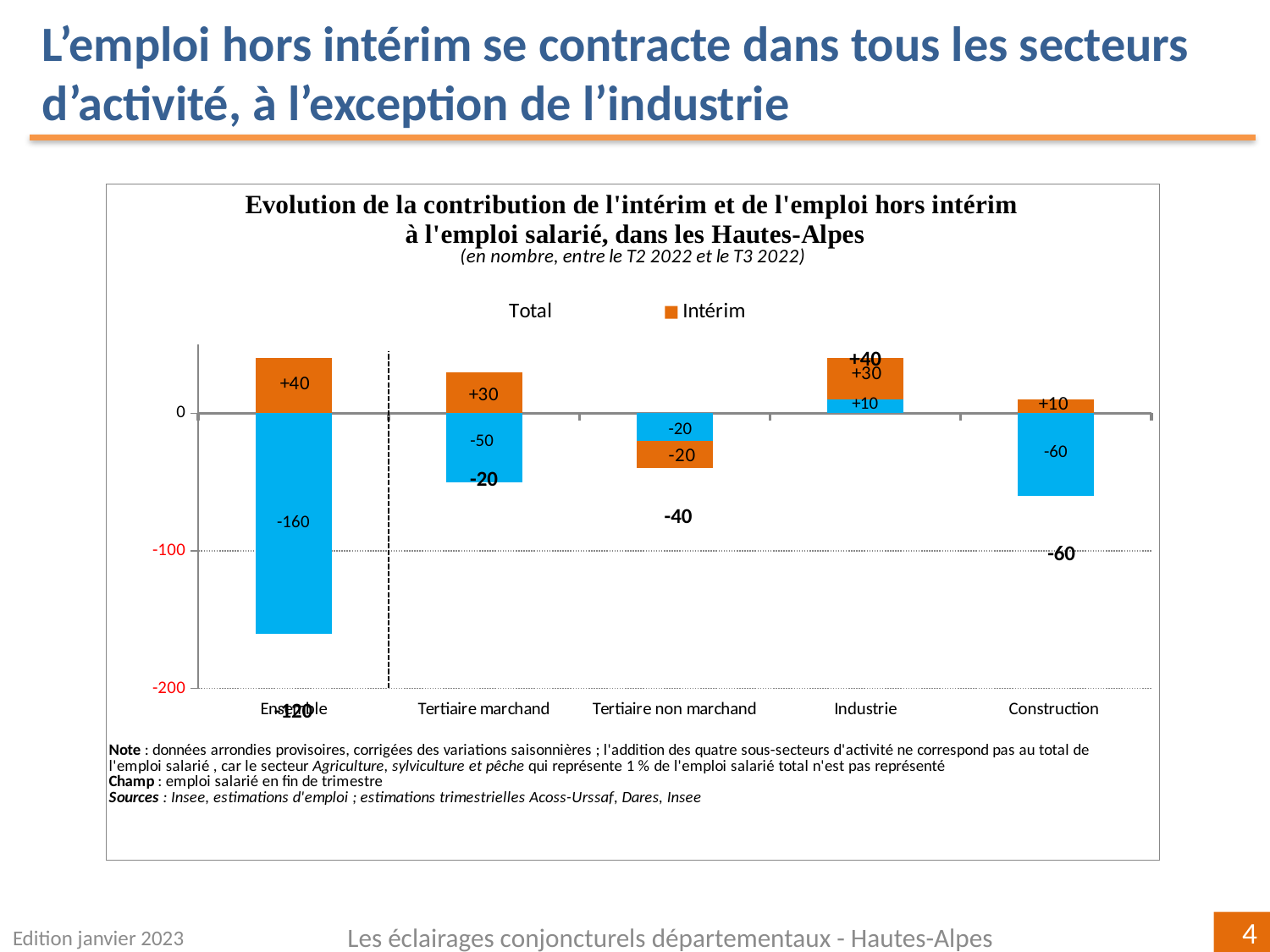
What is the value of the blue (hors intérim) bar for Ensemble? -160 What is the value of the blue (hors intérim) bar for Construction? -60 What is the Total value shown for Tertiaire non marchand? -40 What is the Intérim value for Ensemble? +40 Which category has the highest Intérim value? Ensemble What is the difference between the Intérim values for Ensemble and Construction? 30 Which sector has the lowest blue (hors intérim) value? Ensemble What is the Total value shown for Industrie? +40 Which is larger, the blue (hors intérim) value for Industrie or for Tertiaire marchand? Industrie What type of chart is this? Bar chart How many sector categories are shown on the x axis? 5 What is the Intérim value for Tertiaire marchand? +30